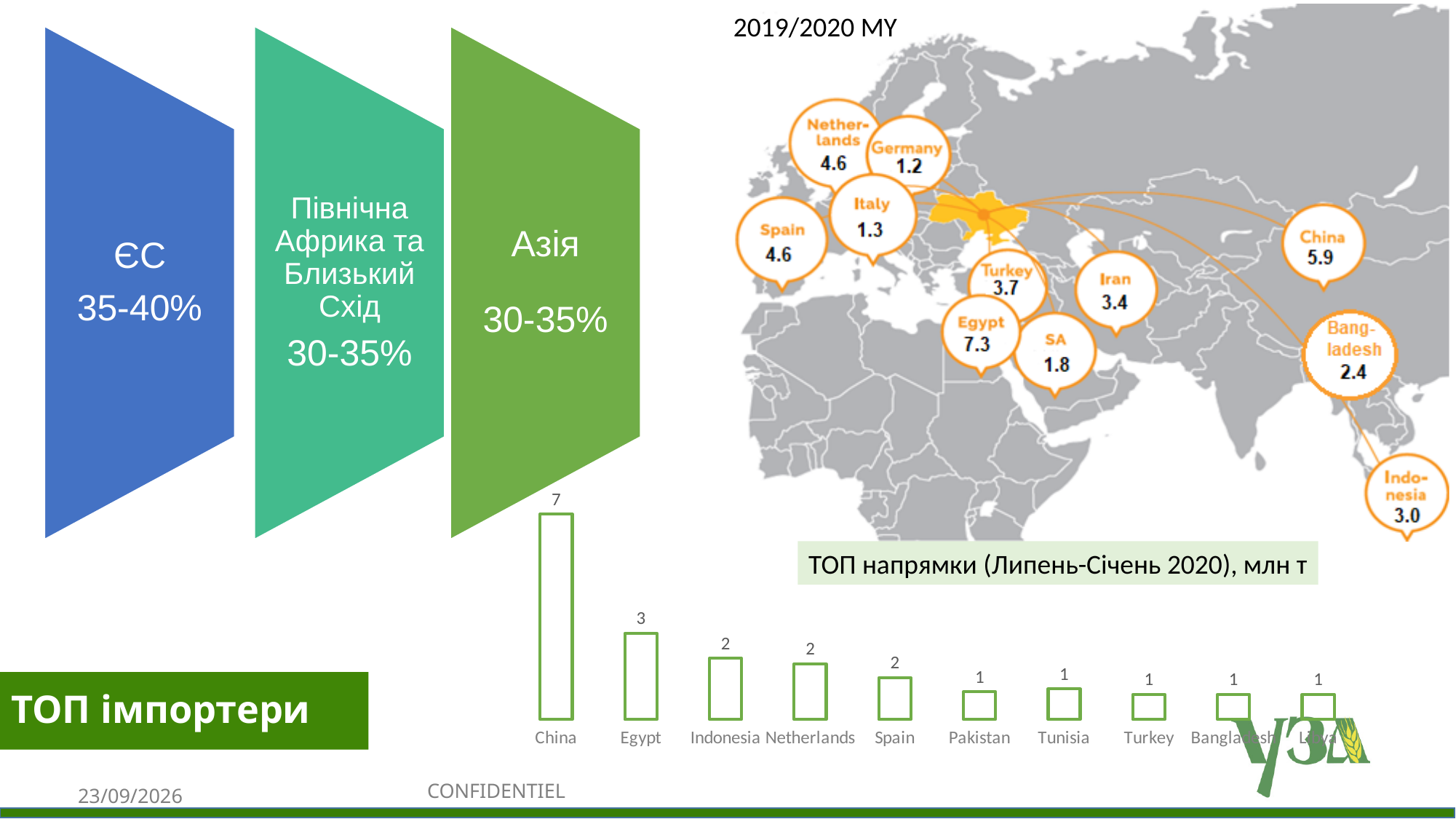
In the bar chart, which is larger, the value for Egypt or the value for Indonesia? Egypt In the bar chart, what is the difference between the values for China and Egypt? 4 In the bar chart, what is the value for Pakistan? 1 In the bar chart, what is the value for Spain? 2 In the bar chart, do the values rise or fall from left to right? Fall In the bar chart, what is the value for China? 7 How many countries are shown in the bar chart? 10 What is the title shown in the green box next to the bar chart? ТОП імпортери On the map, what value is shown for Egypt? 7.3 In the bar chart, what is the value for Egypt? 3 What kind of chart is shown at the bottom of the slide? Bar chart In the bar chart, which country has the highest value? China